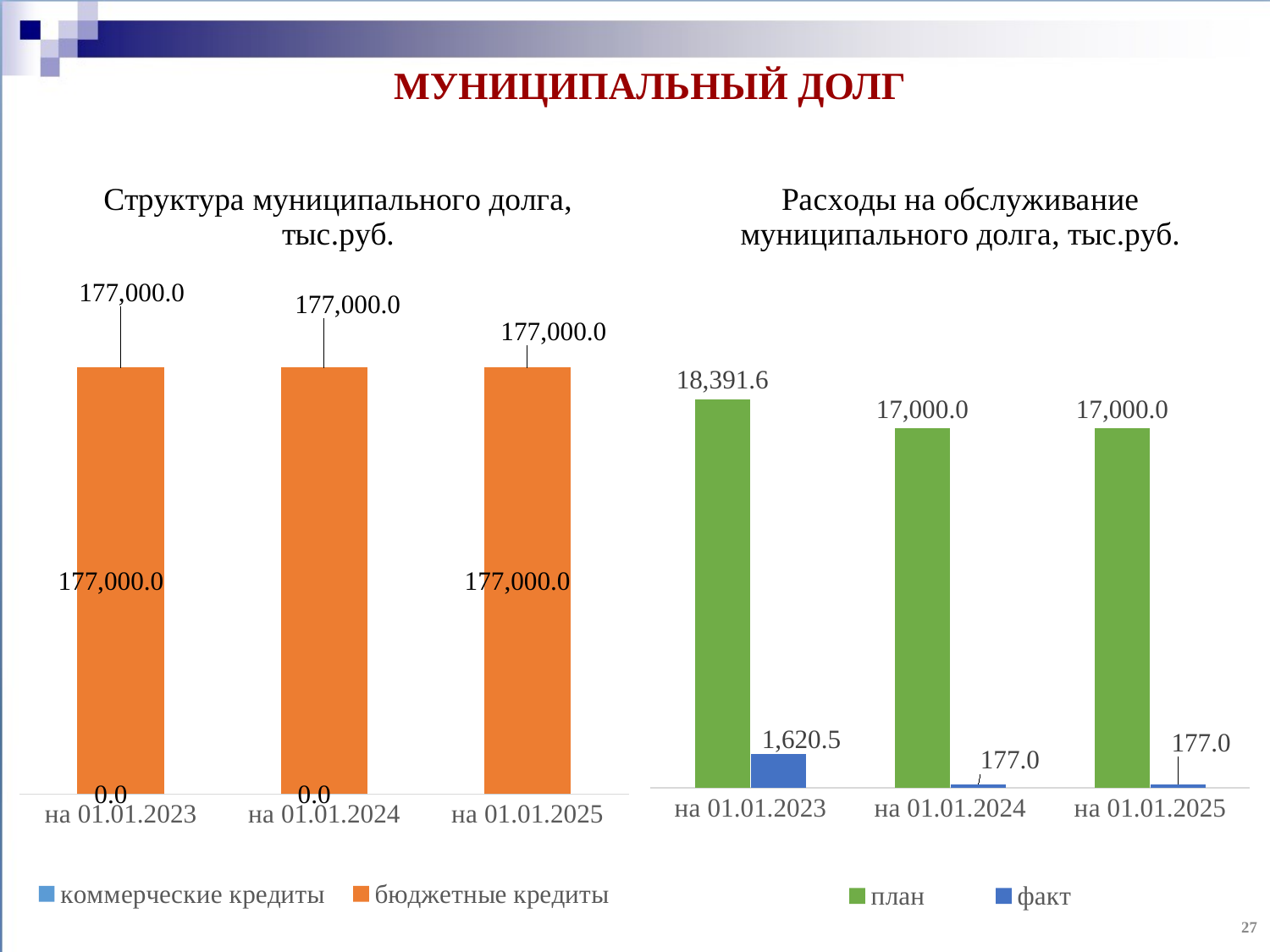
In the chart 'Расходы на обслуживание муниципального долга, тыс.руб.', which date has the highest план value? на 01.01.2023 What kind of chart is 'Структура муниципального долга, тыс.руб.'? bar chart In the chart 'Расходы на обслуживание муниципального долга, тыс.руб.', by how much does план for на 01.01.2023 exceed план for на 01.01.2024? 1,391.6 How many dates are shown on the x axis of the chart 'Структура муниципального долга, тыс.руб.'? 3 In the chart 'Структура муниципального долга, тыс.руб.', what is the value of коммерческие кредиты for на 01.01.2023? 0.0 In the chart 'Структура муниципального долга, тыс.руб.', what is the value of бюджетные кредиты for на 01.01.2024? 177,000.0 In the chart 'Расходы на обслуживание муниципального долга, тыс.руб.', which is larger: факт for на 01.01.2023 or факт for на 01.01.2024? факт for на 01.01.2023 How many series does the legend of the chart 'Расходы на обслуживание муниципального долга, тыс.руб.' list? 2 In the chart 'Расходы на обслуживание муниципального долга, тыс.руб.', what is the difference between план and факт for на 01.01.2023? 16,771.1 In the chart 'Расходы на обслуживание муниципального долга, тыс.руб.', what is the план value for на 01.01.2023? 18,391.6 In the chart 'Расходы на обслуживание муниципального долга, тыс.руб.', what is the факт value for на 01.01.2023? 1,620.5 In the chart 'Расходы на обслуживание муниципального долга, тыс.руб.', what is the факт value for на 01.01.2025? 177.0